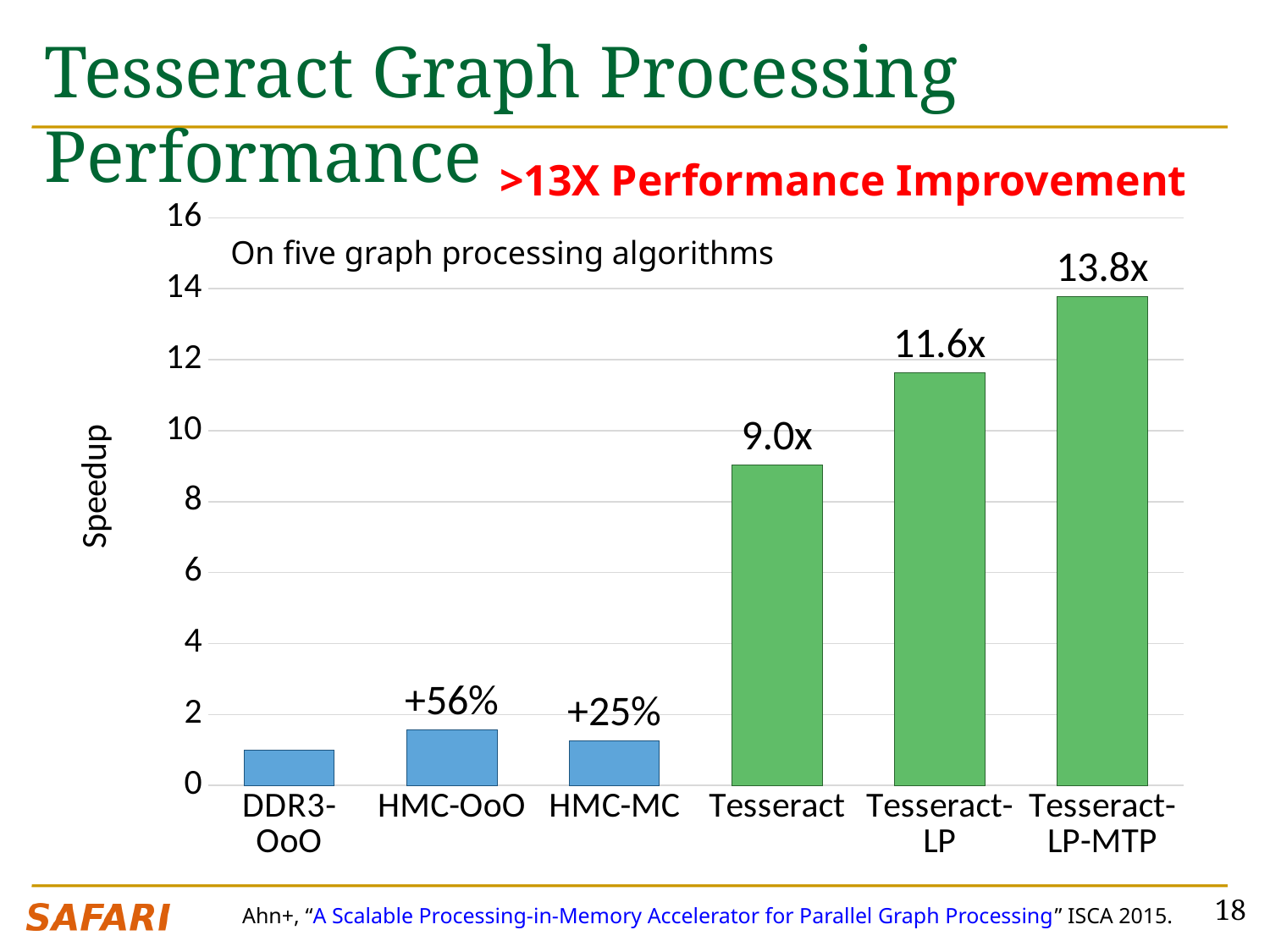
What is the difference between the speedup of Tesseract-LP-MTP and Tesseract? 4.8x Which category has the lowest speedup? DDR3-OoO What label is printed above the HMC-OoO bar? +56% What is the speedup shown for Tesseract-LP? 11.6x What is the speedup shown for Tesseract? 9.0x How many categories are shown on the x axis? 6 Which has a larger speedup, Tesseract-LP or Tesseract? Tesseract-LP What is the speedup shown for Tesseract-LP-MTP? 13.8x Is the value for DDR3-OoO greater or less than 2? less What label is printed above the HMC-MC bar? +25% What kind of chart is shown on the slide? bar chart Which category has the highest speedup? Tesseract-LP-MTP